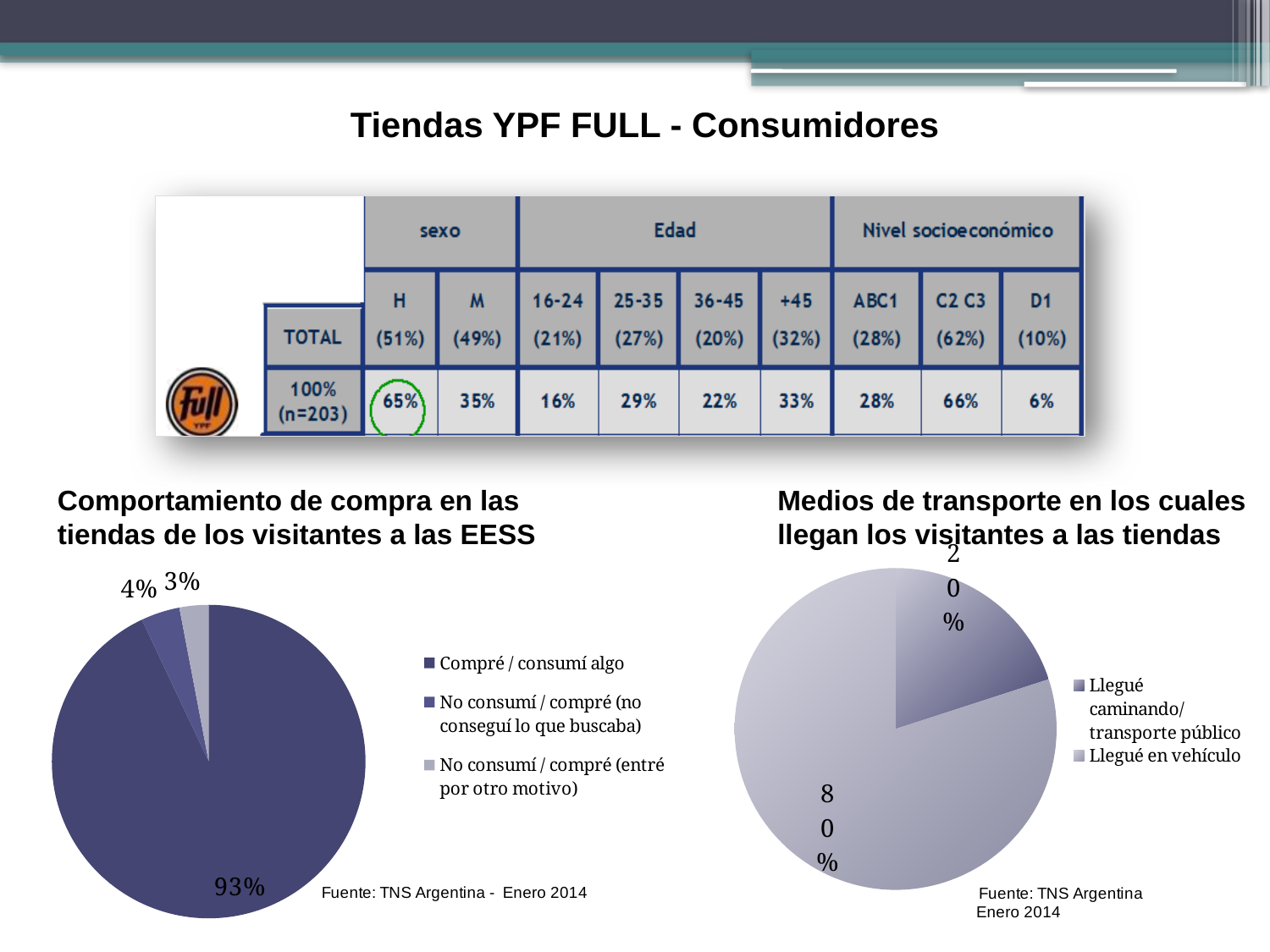
In the 'Comportamiento de compra' pie chart, what share is 'Compré / consumí algo'? 93% In the 'Comportamiento de compra' pie chart, what share is 'No consumí / compré (entré por otro motivo)'? 3% How many slices does the 'Comportamiento de compra' pie chart have? 3 In the 'Comportamiento de compra' pie chart, which category has the smallest slice? No consumí / compré (entré por otro motivo) How many entries does the legend of the 'Medios de transporte' pie chart list? 2 In the 'Comportamiento de compra' pie chart, what share is 'No consumí / compré (no conseguí lo que buscaba)'? 4% What kind of chart is the 'Comportamiento de compra en las tiendas de los visitantes a las EESS' chart? Pie chart In the 'Medios de transporte' pie chart, which is larger: 'Llegué en vehículo' or 'Llegué caminando/ transporte público'? Llegué en vehículo In the 'Comportamiento de compra' pie chart, what is the difference between the 'Compré / consumí algo' slice and the 'No consumí / compré (no conseguí lo que buscaba)' slice? 89% In the 'Comportamiento de compra' pie chart, which category has the largest slice? Compré / consumí algo